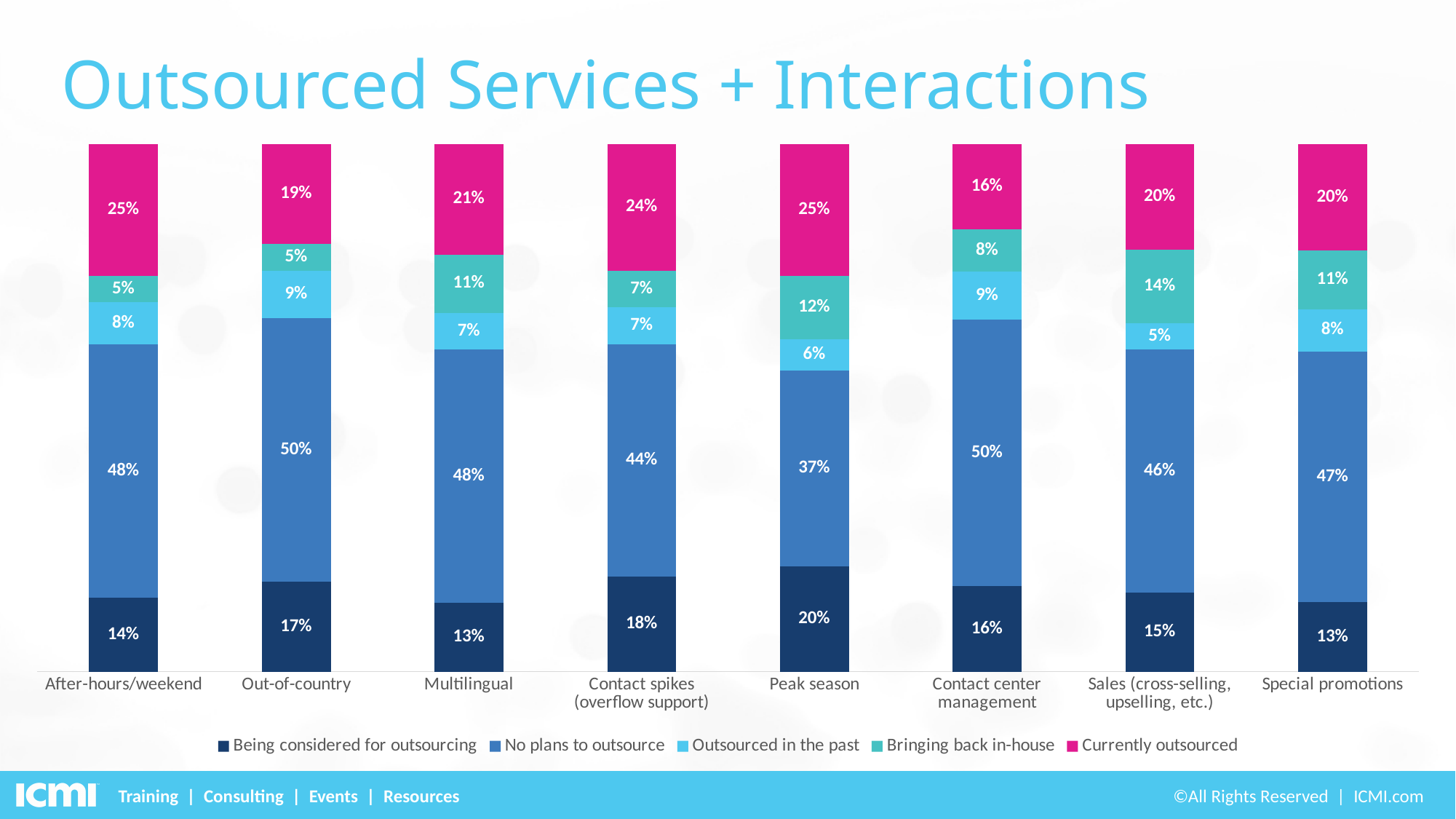
How many categories are shown on the x axis? 8 What is the difference between the 'Currently outsourced' values for After-hours/weekend and Contact center management? 9% What is the 'Bringing back in-house' value for Sales (cross-selling, upselling, etc.)? 14% Which category has the highest 'Being considered for outsourcing' value? Peak season Which is larger: the 'Outsourced in the past' value for Out-of-country or for Special promotions? Out-of-country Which category has the lowest 'No plans to outsource' value? Peak season How many series does the legend list? 5 What percentage of respondents say Multilingual is currently outsourced? 21% What kind of chart is shown on the slide? Stacked bar chart What is the total of the stacked bar for Contact spikes (overflow support)? 100% What is the 'No plans to outsource' value for Peak season? 37% Which series is shown in pink at the top of each bar? Currently outsourced